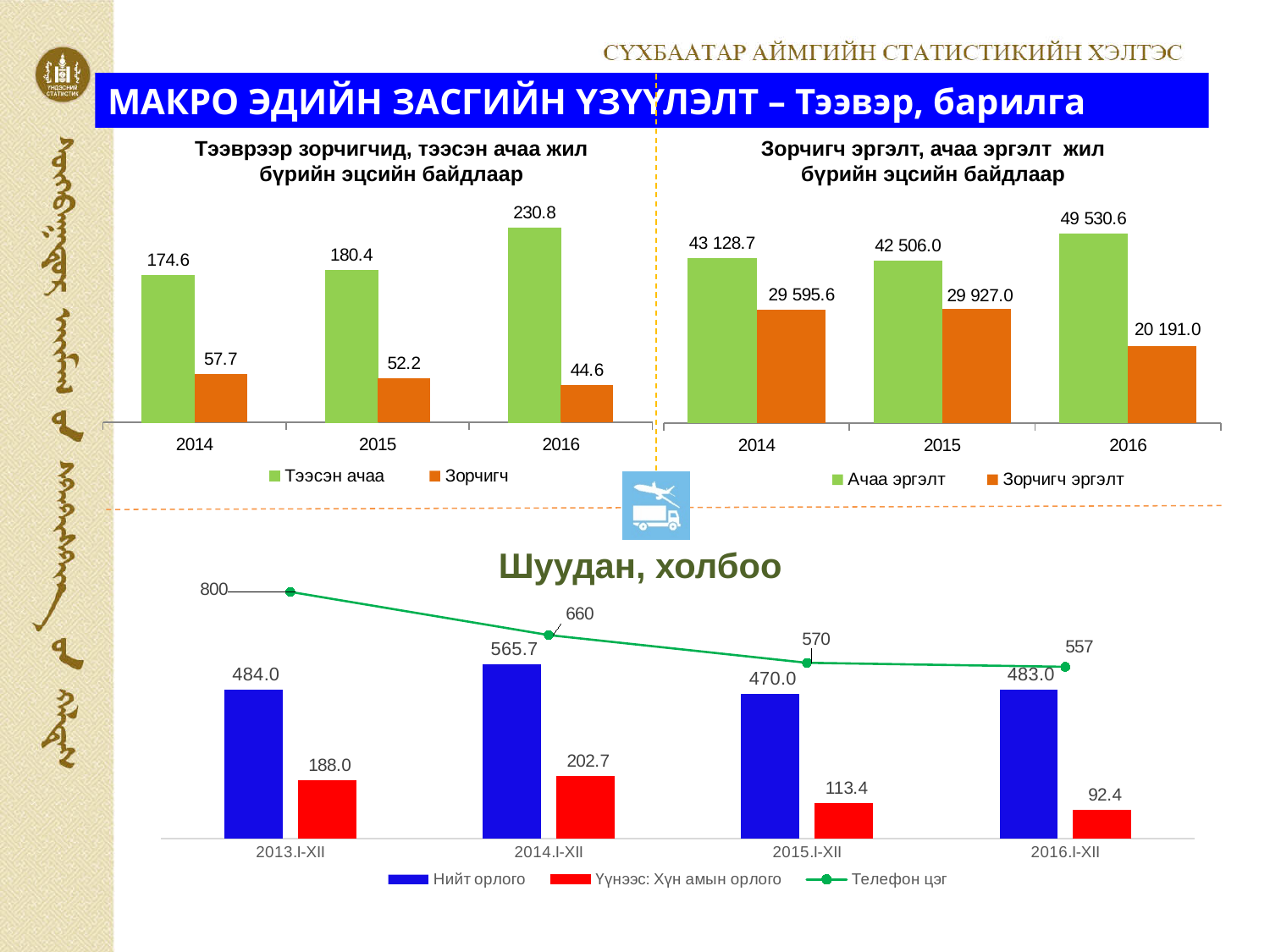
In the bottom chart 'Шуудан, холбоо', how many categories are shown on the x axis? 4 In the bottom chart 'Шуудан, холбоо', what is the difference between the Үүнээс: Хүн амын орлого values for 2014.I-XII and 2016.I-XII? 110.3 In the bottom chart 'Шуудан, холбоо', what is the value of Нийт орлого for 2014.I-XII? 565.7 In the top-left chart 'Тээврээр зорчигчид, тээсэн ачаа жил бүрийн эцсийн байдлаар', what is the difference between the Тээсэн ачаа values for 2016 and 2015? 50.4 In the top-right chart 'Зорчигч эргэлт, ачаа эргэлт жил бүрийн эцсийн байдлаар', what is the value of Зорчигч эргэлт for 2016? 20 191.0 In the top-left chart 'Тээврээр зорчигчид, тээсэн ачаа жил бүрийн эцсийн байдлаар', do the Зорчигч values rise or fall from 2014 to 2016? fall In the top-right chart 'Зорчигч эргэлт, ачаа эргэлт жил бүрийн эцсийн байдлаар', which is larger: Зорчигч эргэлт in 2014 or in 2015? 2015 In the top-right chart 'Зорчигч эргэлт, ачаа эргэлт жил бүрийн эцсийн байдлаар', how many series does the legend list? 2 In the bottom chart 'Шуудан, холбоо', what is the value of Телефон цэг for 2016.I-XII? 557 In the top-left chart 'Тээврээр зорчигчид, тээсэн ачаа жил бүрийн эцсийн байдлаар', which year has the lowest value for Зорчигч? 2016 In the top-right chart 'Зорчигч эргэлт, ачаа эргэлт жил бүрийн эцсийн байдлаар', which year has the highest value for Ачаа эргэлт? 2016 In the top-left chart 'Тээврээр зорчигчид, тээсэн ачаа жил бүрийн эцсийн байдлаар', what is the value of Тээсэн ачаа for 2016? 230.8